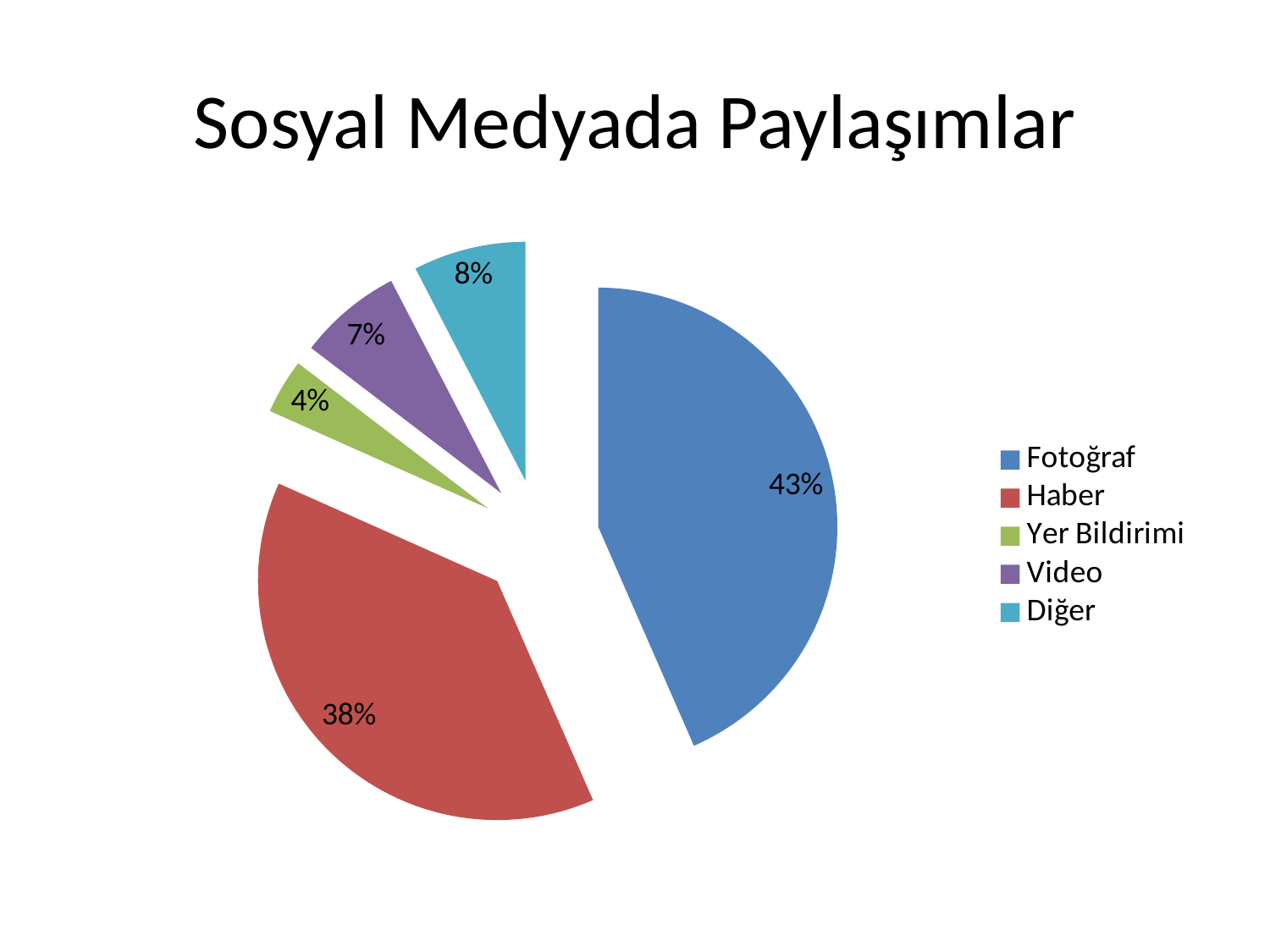
Which category has the largest slice of the pie? Fotoğraf What share of the pie does Haber have? 38% What type of chart is shown on the slide? pie chart What share of the pie does Video have? 7% Which is larger, the share for Video or the share for Diğer? Diğer How many categories does the legend list? 5 What share of the pie does Fotoğraf have? 43% What is the difference in percentage points between Fotoğraf and Haber? 5 Which category has the smallest slice of the pie? Yer Bildirimi What is the title of the chart? Sosyal Medyada Paylaşımlar